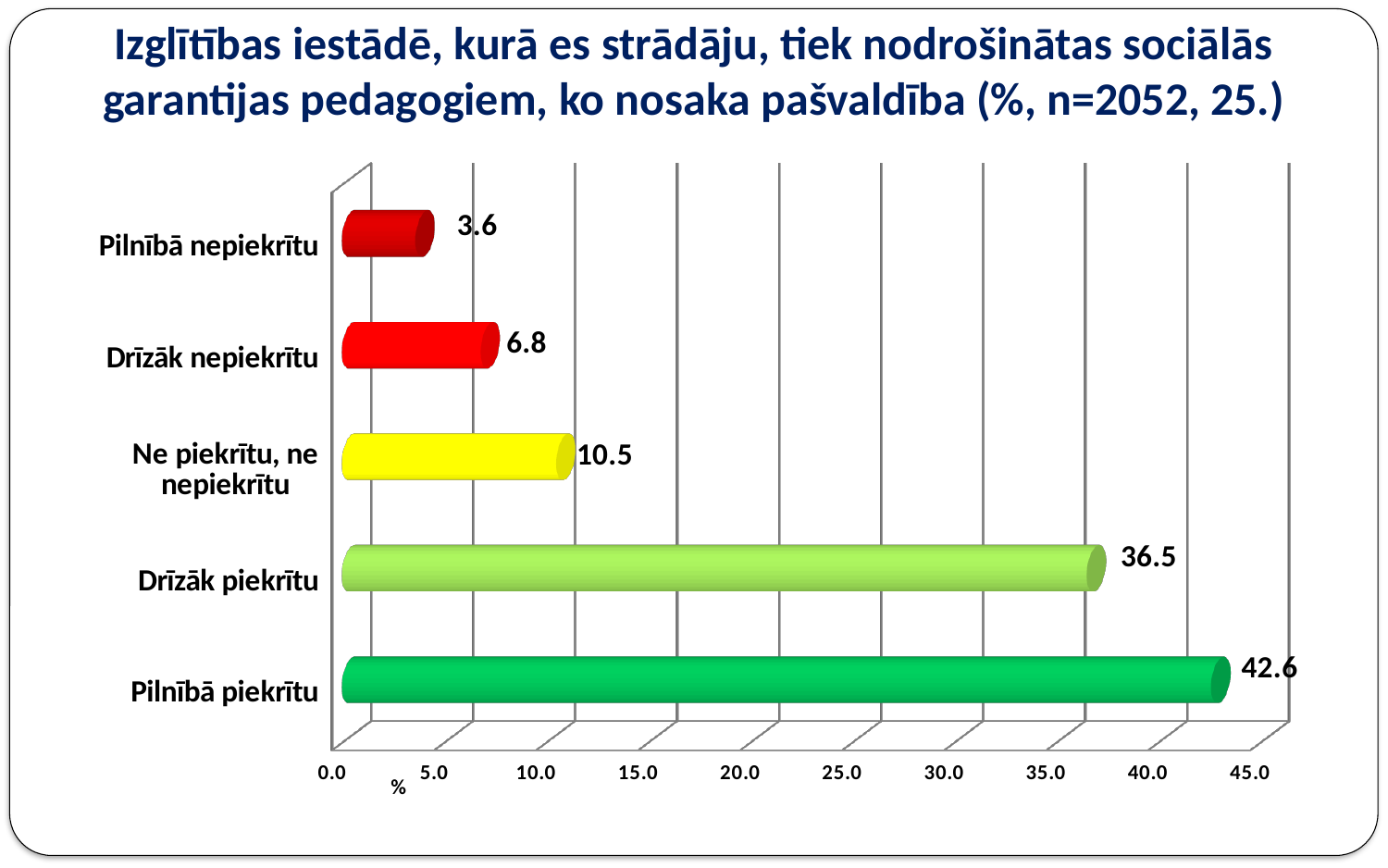
Which category has the highest value? Pilnībā piekrītu What is the difference between the values for "Pilnībā piekrītu" and "Drīzāk piekrītu"? 6.1 What is the value for "Drīzāk nepiekrītu"? 6.8 What is the difference between the values for "Drīzāk nepiekrītu" and "Pilnībā nepiekrītu"? 3.2 What is the value for "Ne piekrītu, ne nepiekrītu"? 10.5 What is the sample size (n) given in the chart title? 2052 What is the value for "Pilnībā piekrītu"? 42.6 Which is larger, the value for "Drīzāk piekrītu" or the value for "Ne piekrītu, ne nepiekrītu"? Drīzāk piekrītu How many categories are shown in the chart? 5 Which category has the lowest value? Pilnībā nepiekrītu Is the value for "Drīzāk piekrītu" greater or less than 40.0? less What kind of chart is shown on the slide? bar chart